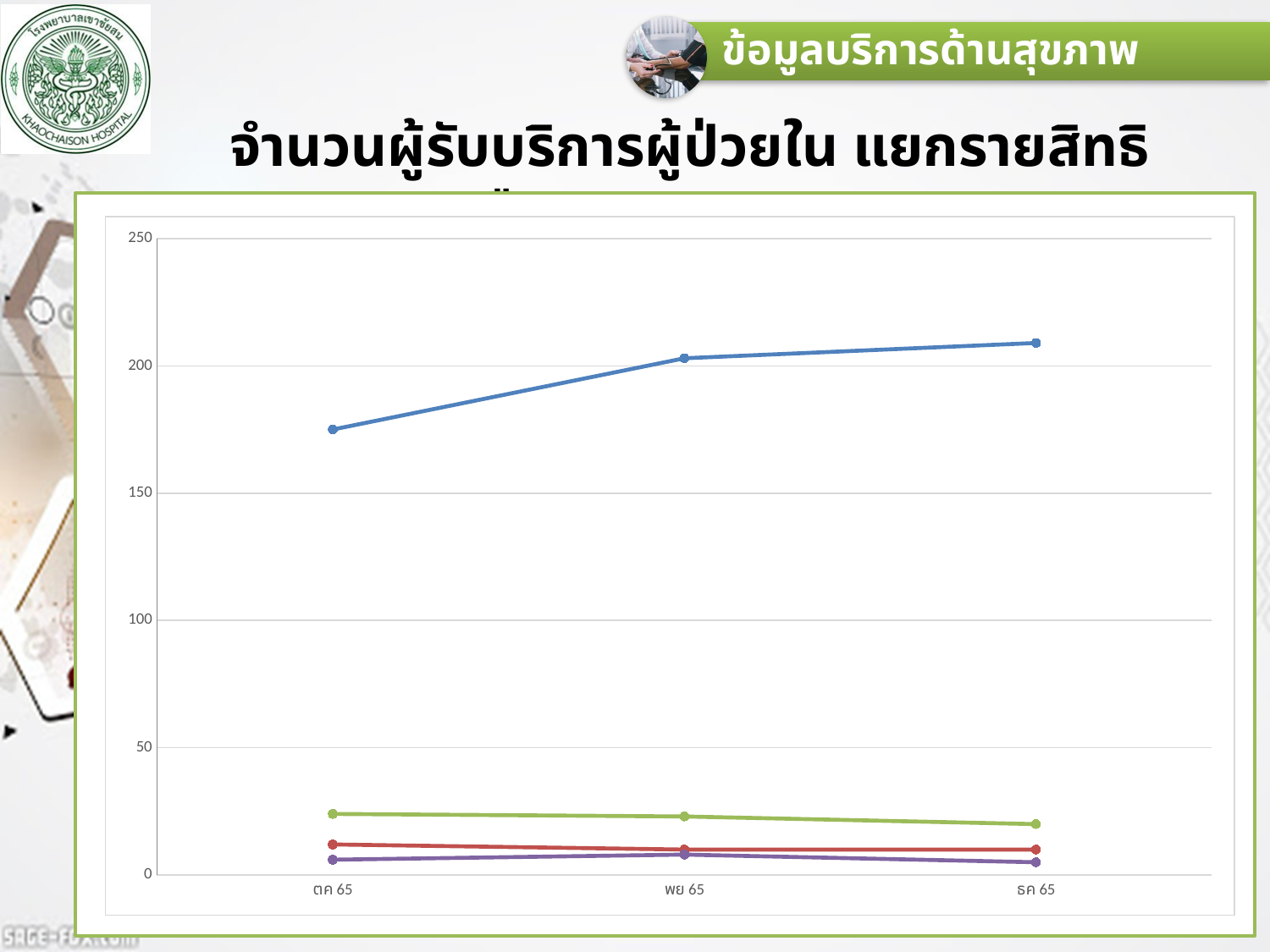
Is the value of the blue line at ตค 65 greater or less than 200? less In which month is the blue line at its lowest value? ตค 65 Which line on the chart has the highest values across all months? the blue line What kind of chart is shown on the slide? line chart Is the value of the green line at พย 65 greater or less than 50? less How many lines are plotted on the chart? 4 Is the value of the blue line at ตค 65 greater or less than 150? greater Does the blue line rise or fall from ตค 65 to ธค 65? rise What is the highest value shown on the y axis of the chart? 250 How many months are shown on the x axis of the chart? 3 Does the green line rise or fall from ตค 65 to ธค 65? fall